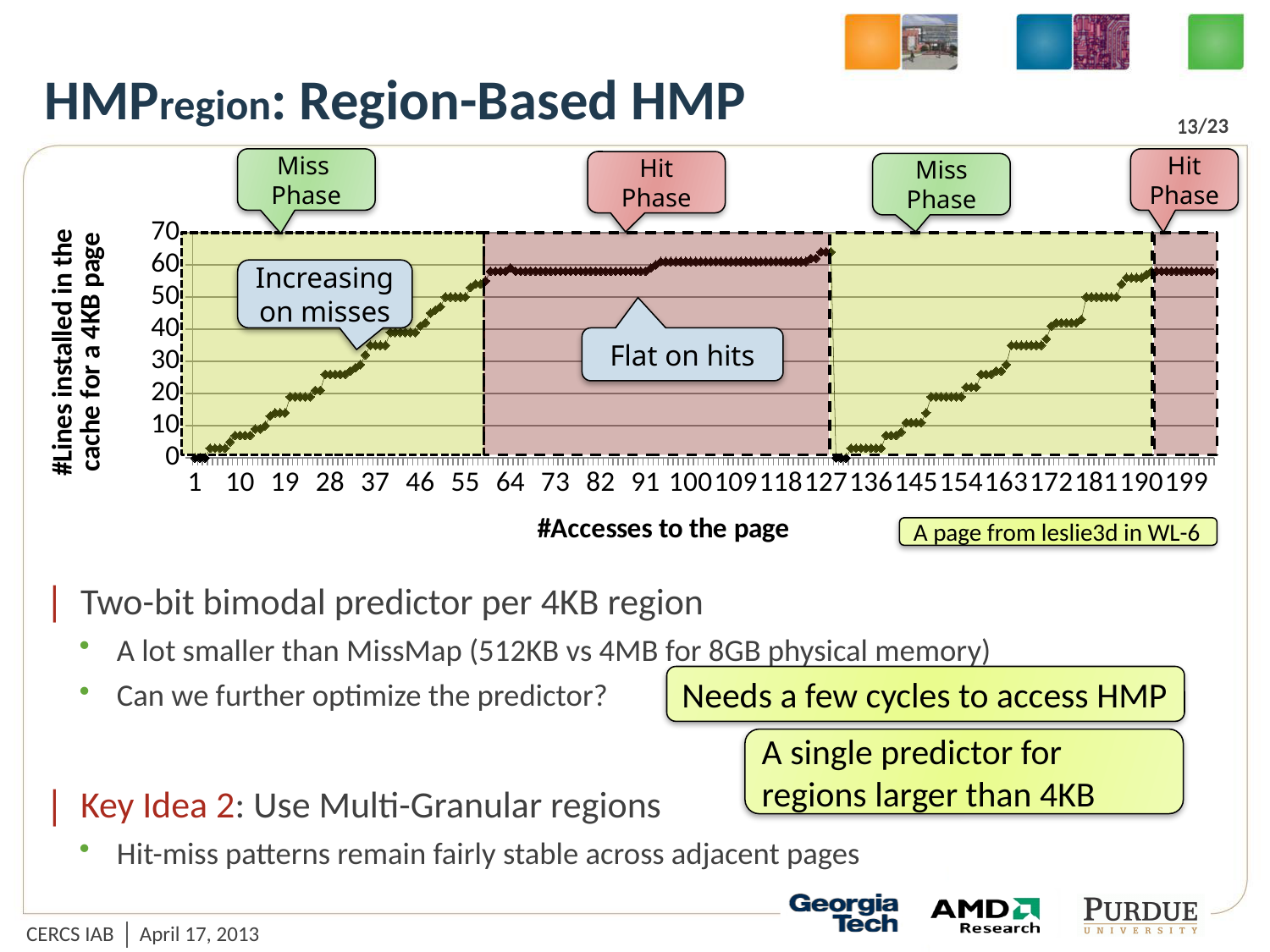
What is the title of the y axis of the chart? #Lines installed in the cache for a 4KB page What kind of chart is shown on the slide? line chart Is the value at access 136 greater or less than 10? less Which is larger, the value at access 127 or the value at access 136? access 127 Do the values rise or fall between access 136 and access 190? rise What is the title of the x axis of the chart? #Accesses to the page Do the values rise or fall between access 1 and access 55? rise Is the value at access 163 greater or less than 40? less Is the value at access 64 greater or less than 50? greater